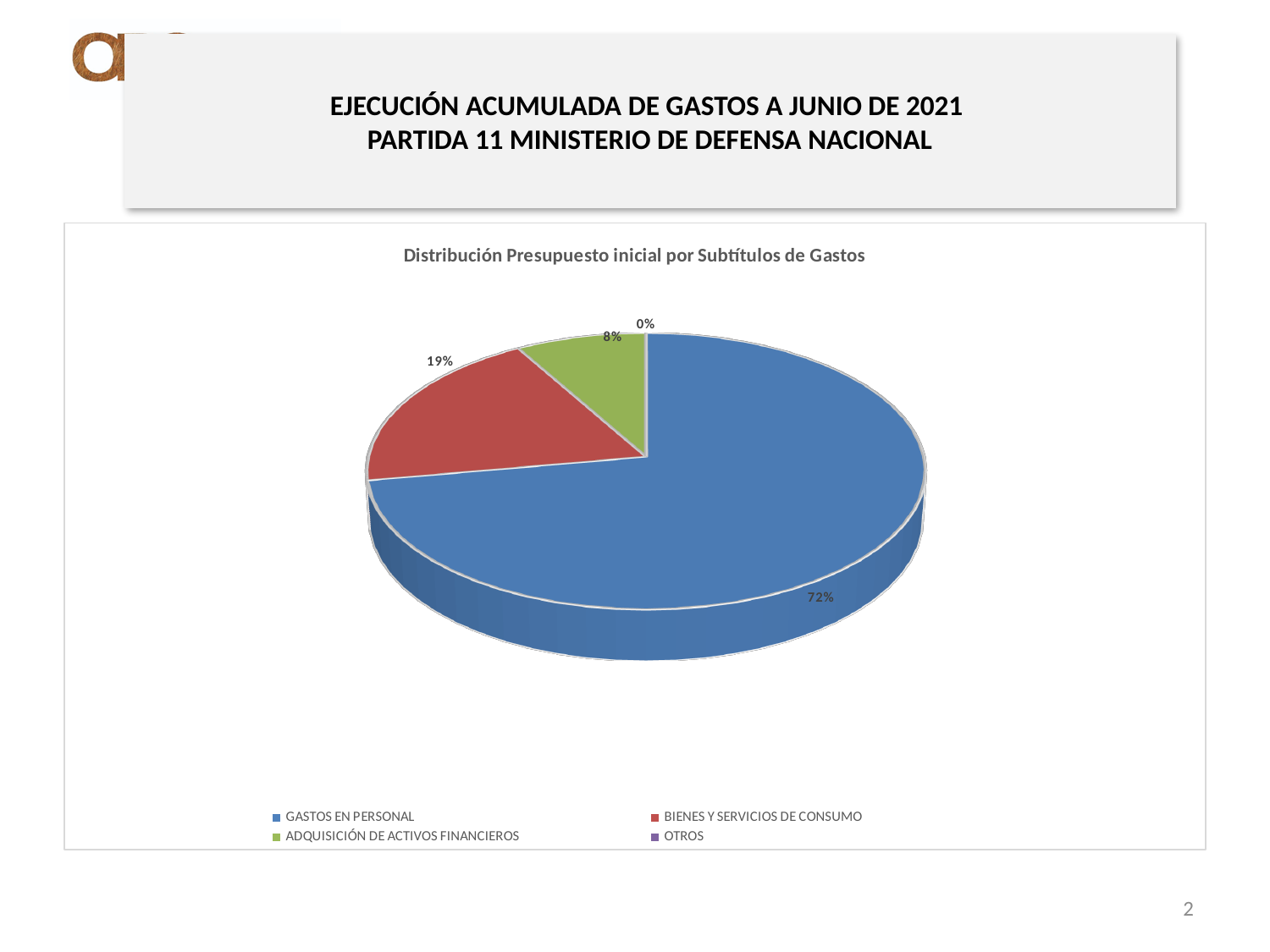
Which is larger: the share for BIENES Y SERVICIOS DE CONSUMO or the share for ADQUISICIÓN DE ACTIVOS FINANCIEROS? BIENES Y SERVICIOS DE CONSUMO How many categories does the legend list? 4 What is the chart's title? Distribución Presupuesto inicial por Subtítulos de Gastos What colour is the slice for BIENES Y SERVICIOS DE CONSUMO? Red What share of the pie does OTROS represent? 0% What share of the pie does ADQUISICIÓN DE ACTIVOS FINANCIEROS represent? 8% Which category has the largest share of the pie? GASTOS EN PERSONAL What is the difference in percentage points between GASTOS EN PERSONAL and BIENES Y SERVICIOS DE CONSUMO? 53 What share of the pie does BIENES Y SERVICIOS DE CONSUMO represent? 19% Which category has the smallest share of the pie? OTROS What kind of chart is shown on the slide? Pie chart